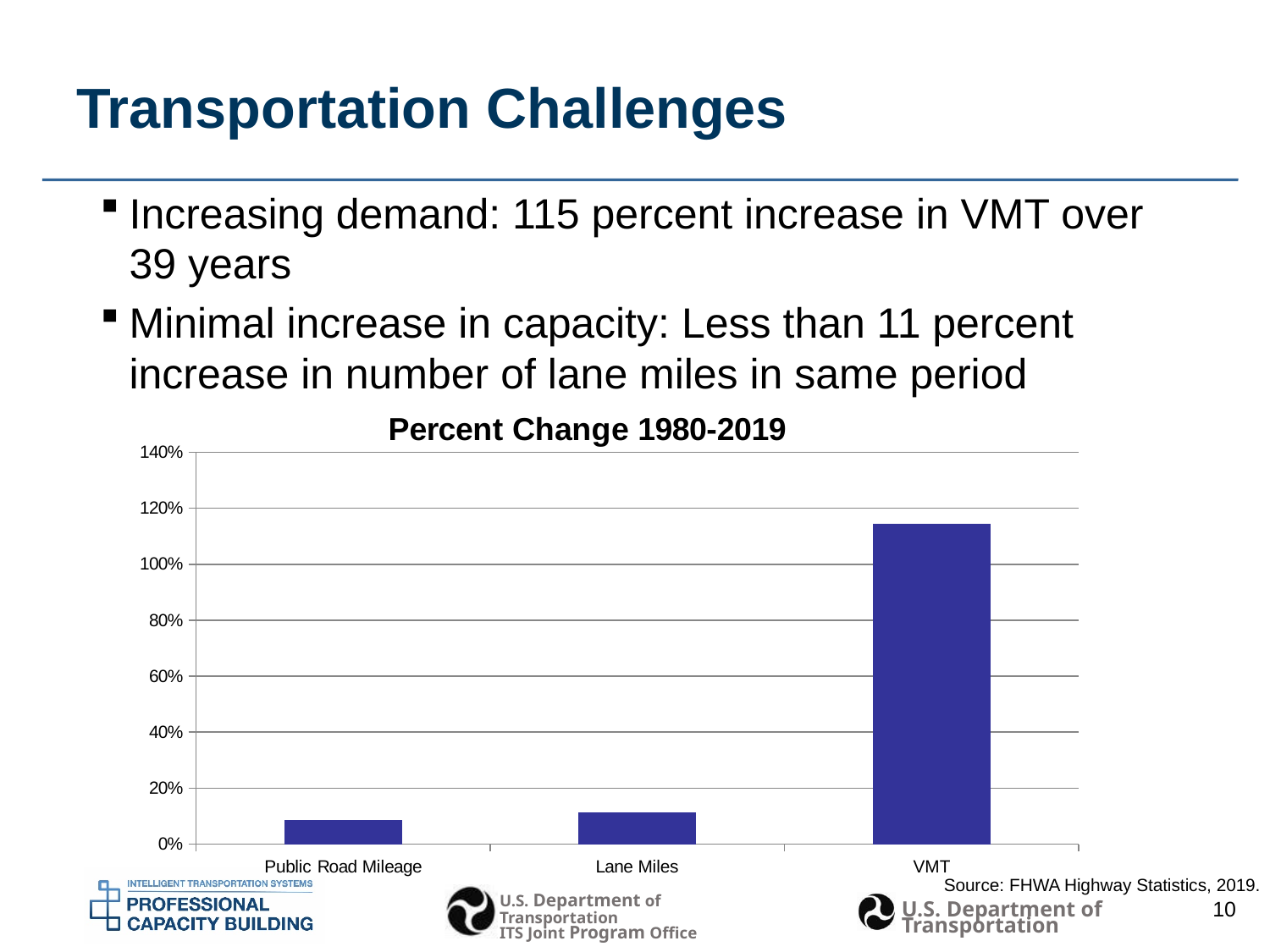
Which category has the lowest percent change? Public Road Mileage How many categories are plotted in the chart? 3 Is the value for Public Road Mileage greater or less than 20%? less What kind of chart is shown on the slide? bar chart Do the values rise or fall moving from left to right across the categories? rise What is the title of the chart? Percent Change 1980-2019 Is the value for VMT greater or less than 100%? greater Is the value for VMT greater or less than 120%? less Which is larger, the percent change for VMT or for Lane Miles? VMT Which category has the highest percent change? VMT What is the highest value shown on the vertical axis? 140%